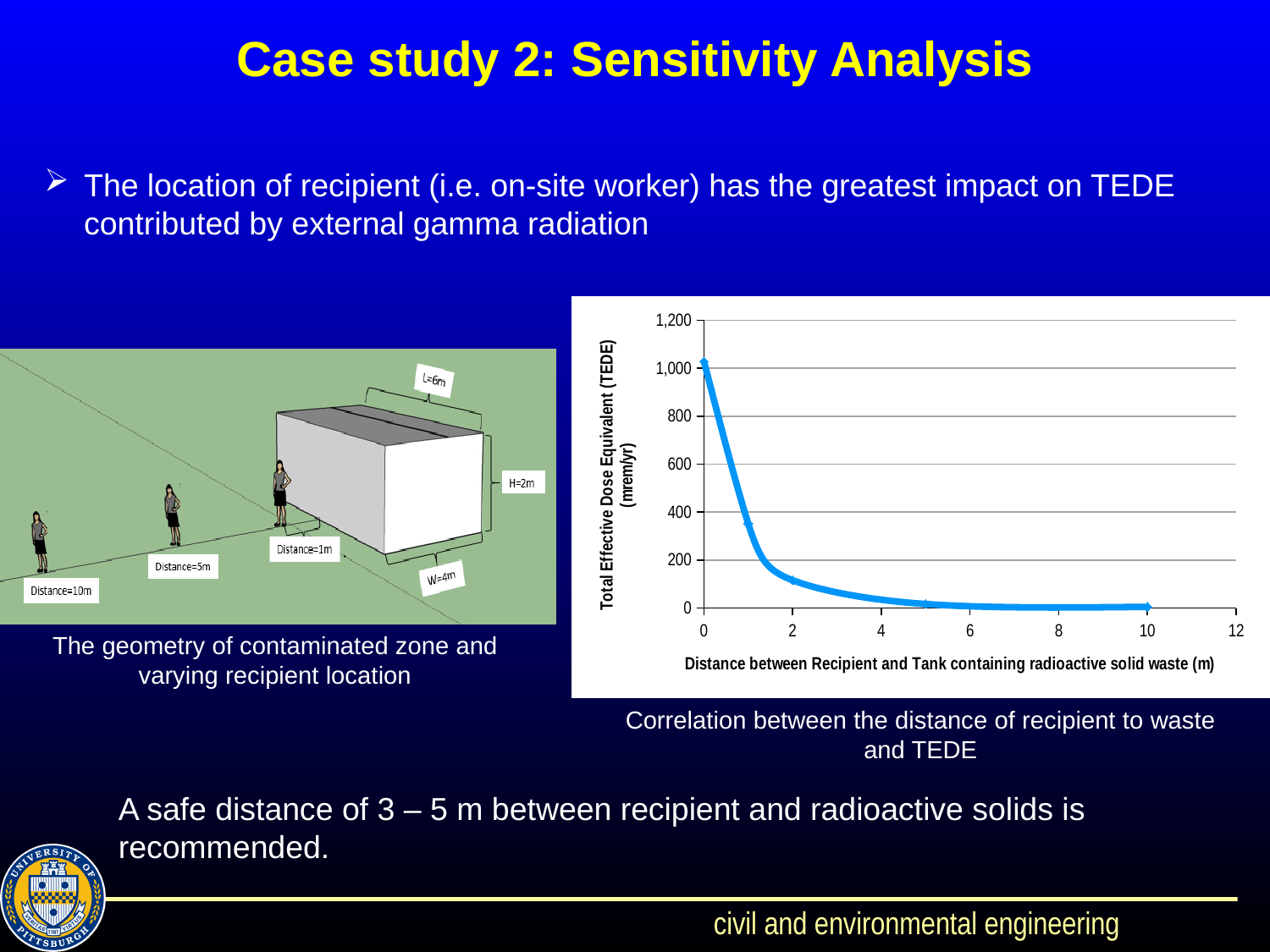
What is the label of the y axis of the chart? Total Effective Dose Equivalent (TEDE) (mrem/yr) Is the Total Effective Dose Equivalent at a distance of 2 m greater or less than 200 mrem/yr? less Is the Total Effective Dose Equivalent at a distance of 1 m greater or less than 400 mrem/yr? less Is the Total Effective Dose Equivalent at a distance of 1 m greater or less than 200 mrem/yr? greater Does the Total Effective Dose Equivalent rise or fall as the distance between recipient and tank increases? fall Which has the larger Total Effective Dose Equivalent: a distance of 1 m or a distance of 2 m? 1 m At which distance is the Total Effective Dose Equivalent highest? 0 m What is the label of the x axis of the chart? Distance between Recipient and Tank containing radioactive solid waste (m) What kind of chart is shown on the slide? line chart